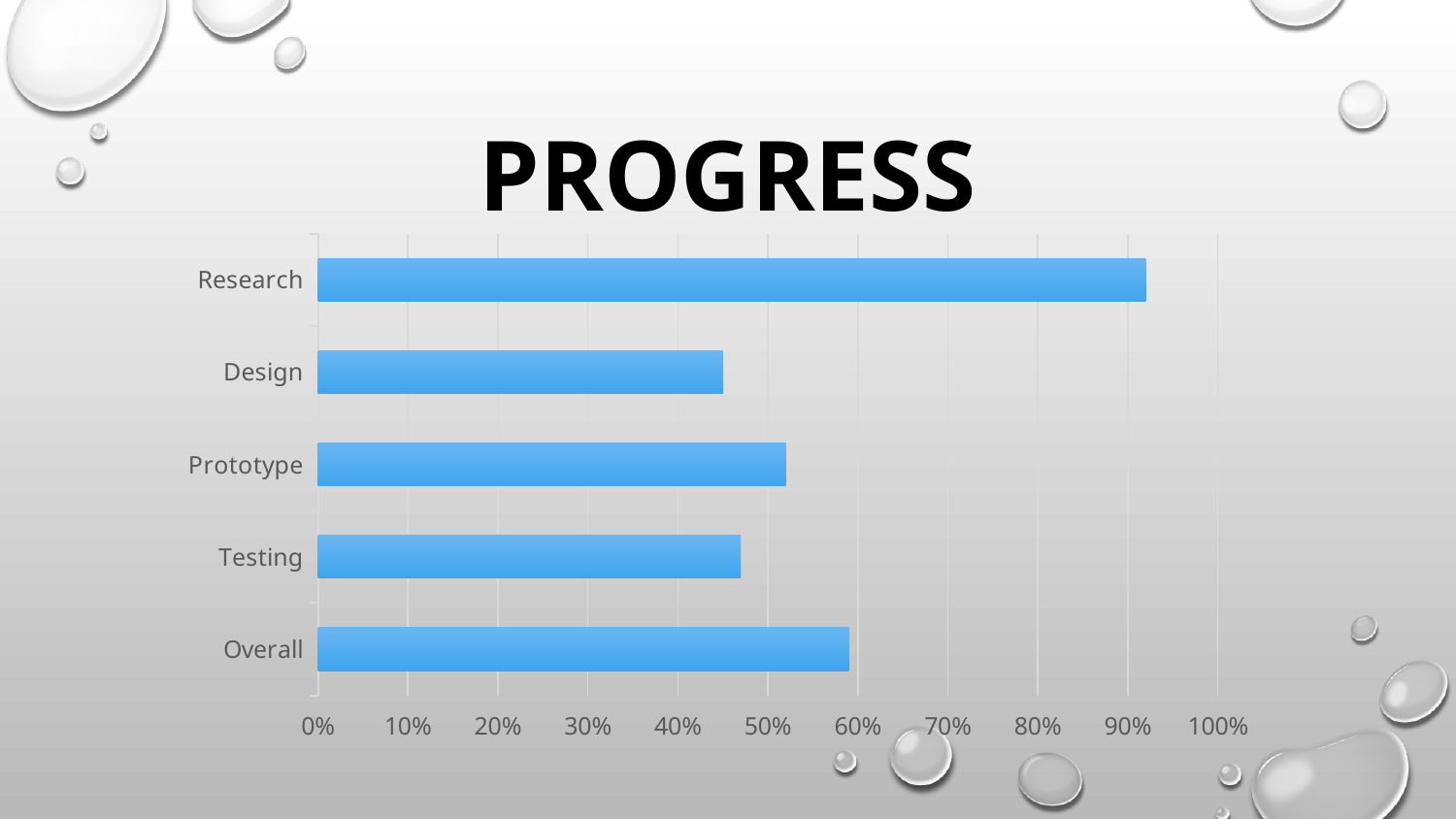
What colour are the bars in the chart? blue Is the value for Design greater or less than 50%? less Is the value for Research greater or less than 80%? greater Is the value for Testing greater or less than 50%? less What is the title of the chart? PROGRESS How many categories are plotted in the chart? 5 Which is larger, the value for Research or the value for Design? Research Which is larger, the value for Overall or the value for Testing? Overall Which category has the highest value? Research What type of chart is shown on the slide? bar chart